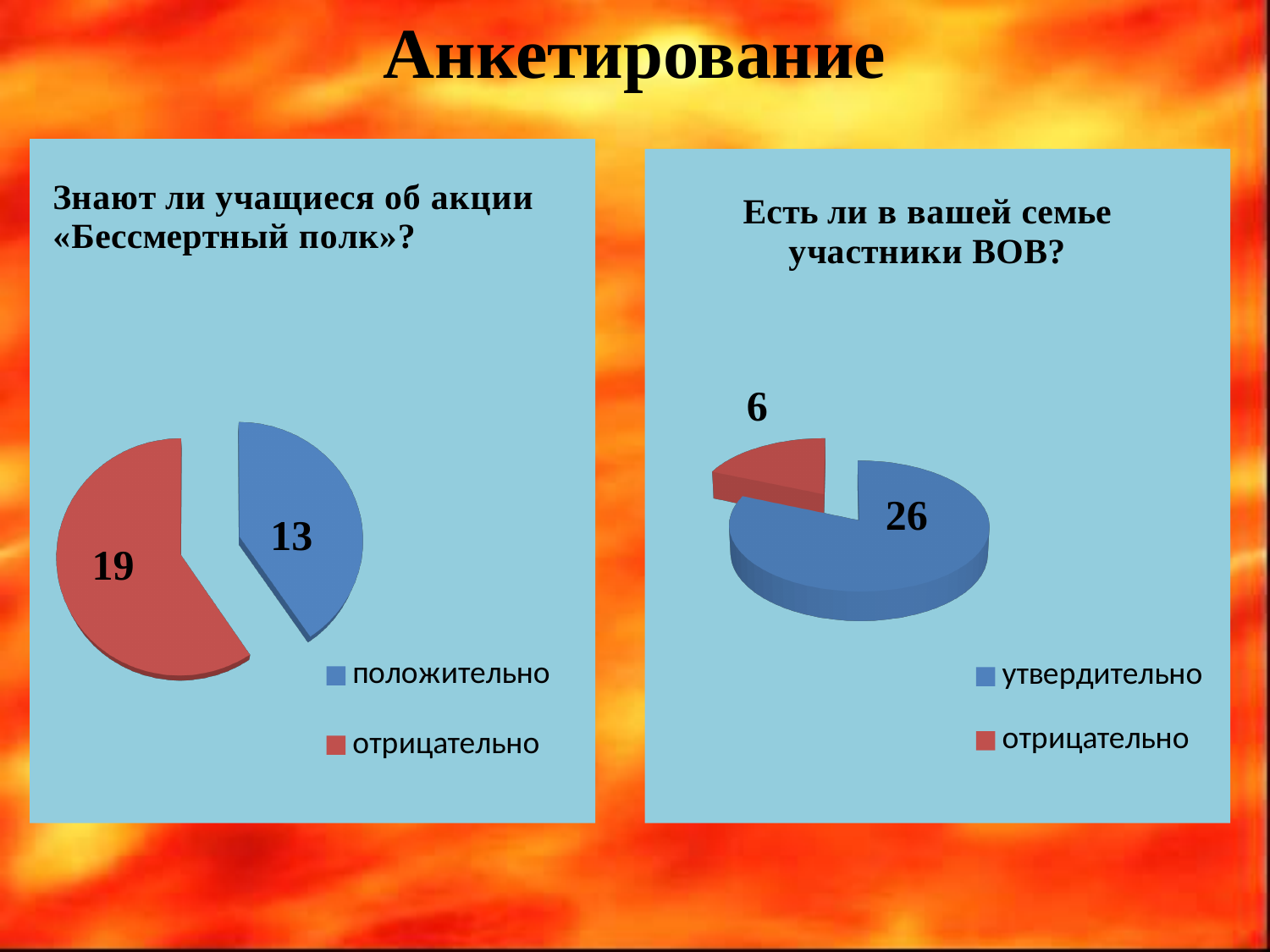
In the left chart (Знают ли учащиеся об акции «Бессмертный полк»?), what is the value for отрицательно? 19 In the left chart (Знают ли учащиеся об акции «Бессмертный полк»?), which category has the largest slice? отрицательно In the right chart (Есть ли в вашей семье участники ВОВ?), what is the value for утвердительно? 26 In the right chart (Есть ли в вашей семье участники ВОВ?), which is larger, утвердительно or отрицательно? утвердительно In the right chart (Есть ли в вашей семье участники ВОВ?), what is the value for отрицательно? 6 In the right chart (Есть ли в вашей семье участники ВОВ?), what share of the total does утвердительно represent? 81.25% How many categories does the legend of the right chart (Есть ли в вашей семье участники ВОВ?) list? 2 In the right chart (Есть ли в вашей семье участники ВОВ?), what is the difference between утвердительно and отрицательно? 20 In the right chart (Есть ли в вашей семье участники ВОВ?), which category has the smallest slice? отрицательно In the left chart (Знают ли учащиеся об акции «Бессмертный полк»?), what is the value for положительно? 13 In the left chart (Знают ли учащиеся об акции «Бессмертный полк»?), what is the difference between отрицательно and положительно? 6 What type of chart is used on the left side of the slide? pie chart